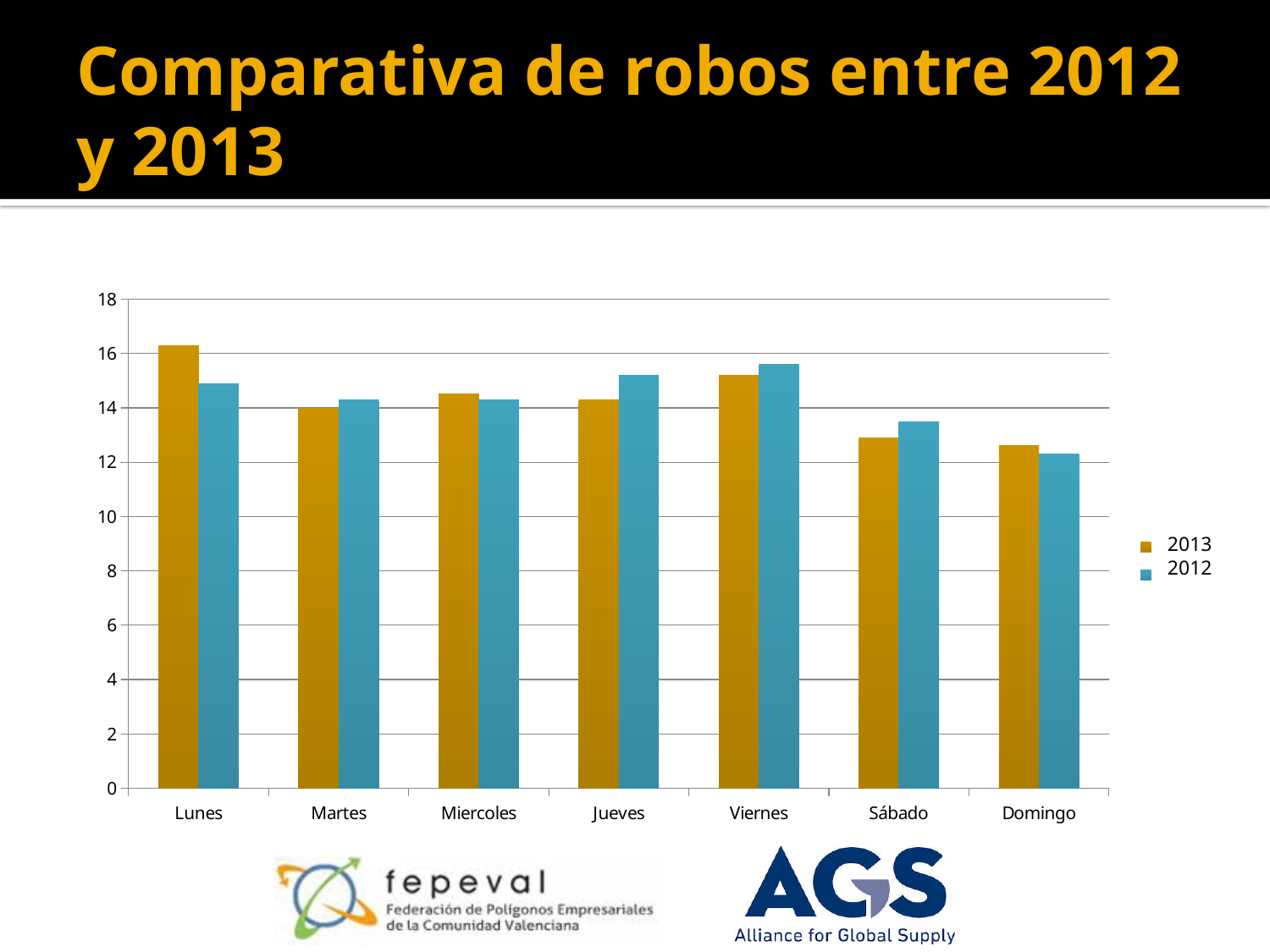
Is the 2012 value for Viernes greater or less than 14? greater Which series is shown in gold/orange bars in the chart? 2013 How many days of the week are shown on the x axis of the chart? 7 For Jueves, which series has the larger value, 2013 or 2012? 2012 Is the 2013 value for Sábado greater or less than 14? less Is the 2012 value for Domingo greater or less than 12? greater How many series does the chart's legend list? 2 Which day has the lowest value for the 2012 series? Domingo What kind of chart is shown on the slide? Bar chart For Lunes, which series has the larger value, 2013 or 2012? 2013 Which day has the highest value for the 2013 series? Lunes